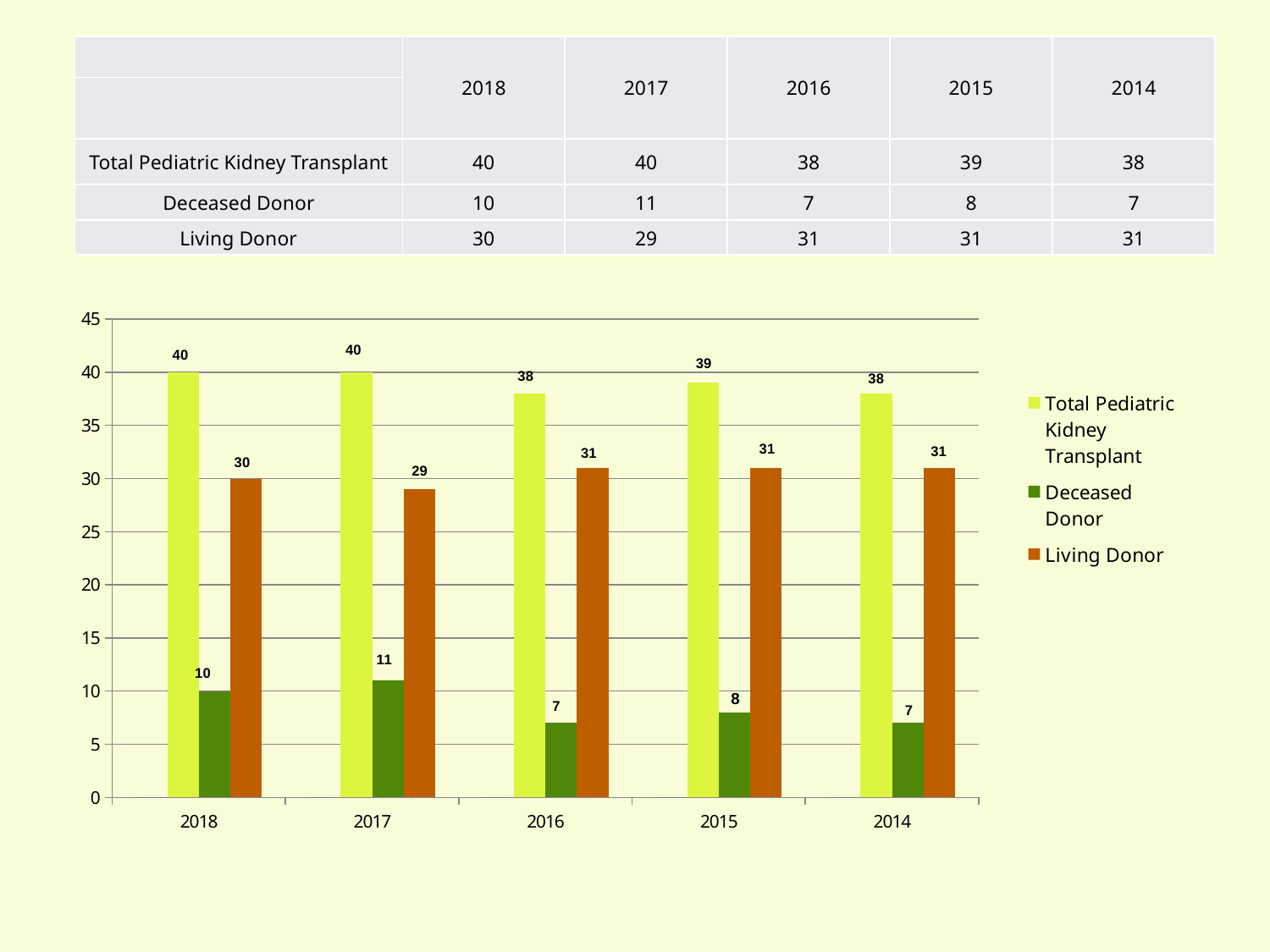
Which is larger, the Deceased Donor value in 2018 or in 2016? 2018 In which year is the Living Donor value lowest? 2017 How many series does the chart legend list? 3 In which year is the Deceased Donor value highest? 2017 What is the value for Living Donor in 2018? 30 Is the Living Donor value for 2017 greater or less than 25? greater What is the value for Total Pediatric Kidney Transplant in 2016? 38 How many years are shown on the x axis of the chart? 5 What is the value for Deceased Donor in 2017? 11 What kind of chart is shown on the slide? bar chart Which series is shown in orange in the chart? Living Donor What is the difference between the Living Donor and Deceased Donor values in 2015? 23